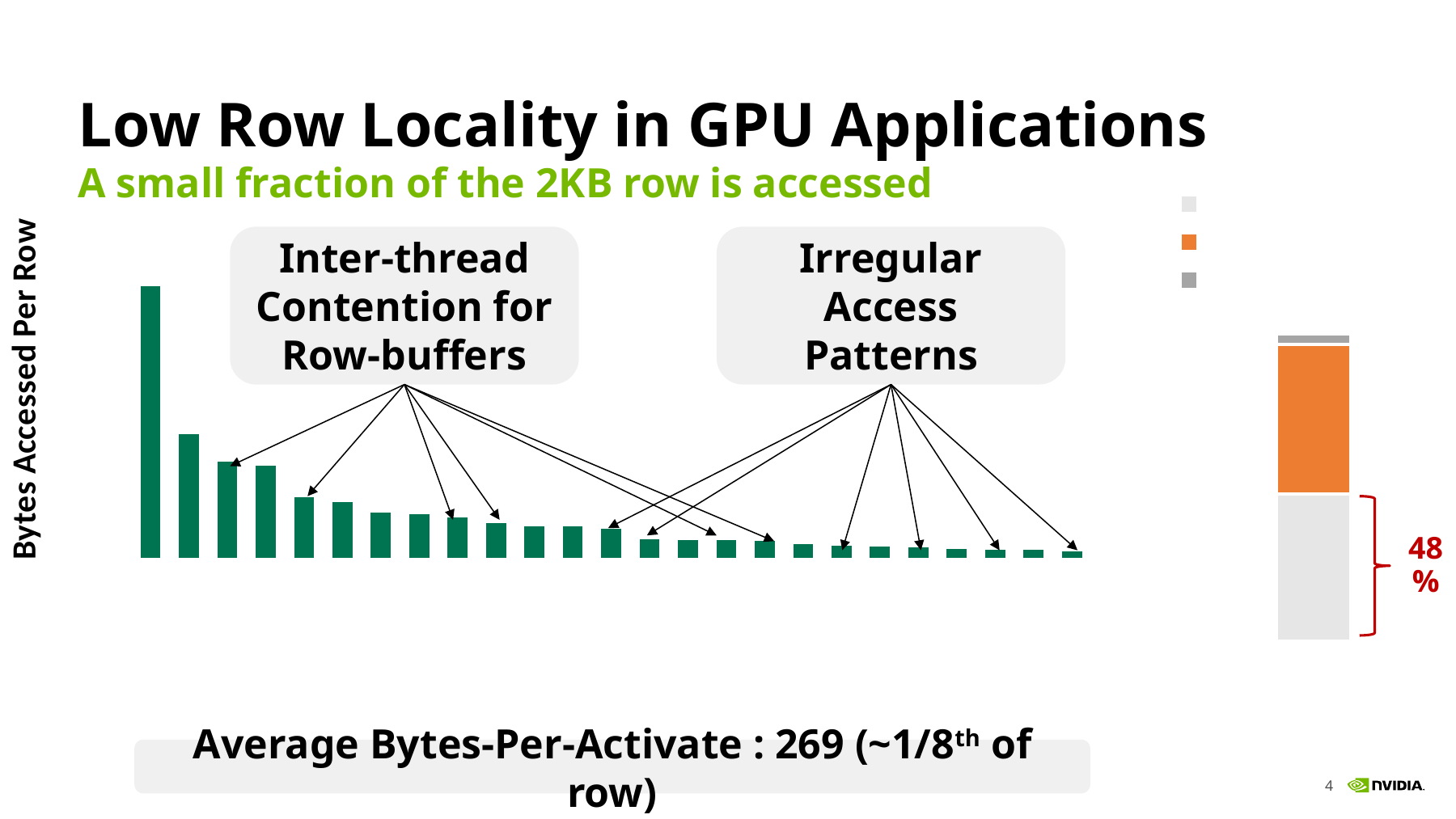
In the main bar chart, which is larger: the second bar or the third bar? the second bar What average Bytes-Per-Activate value is stated below the main bar chart? 269 In the main bar chart, which bar is the lowest? the rightmost bar What kind of chart is the main chart on the left of the slide? bar chart In the stacked bar on the right, which segment is larger: the orange segment or the dark grey segment at the top? the orange segment In the main bar chart, which bar is the highest? the leftmost bar In the main bar chart, which is larger: the first (leftmost) bar or the second bar? the first (leftmost) bar In the stacked bar on the right of the slide, what percentage is labelled for the light grey segment? 48% How many green bars are plotted in the main bar chart? 25 In the main bar chart, do the bar values rise or fall from left to right? fall What is the label on the vertical axis of the main bar chart? Bytes Accessed Per Row How many colour entries does the legend at the top right of the slide show? 3